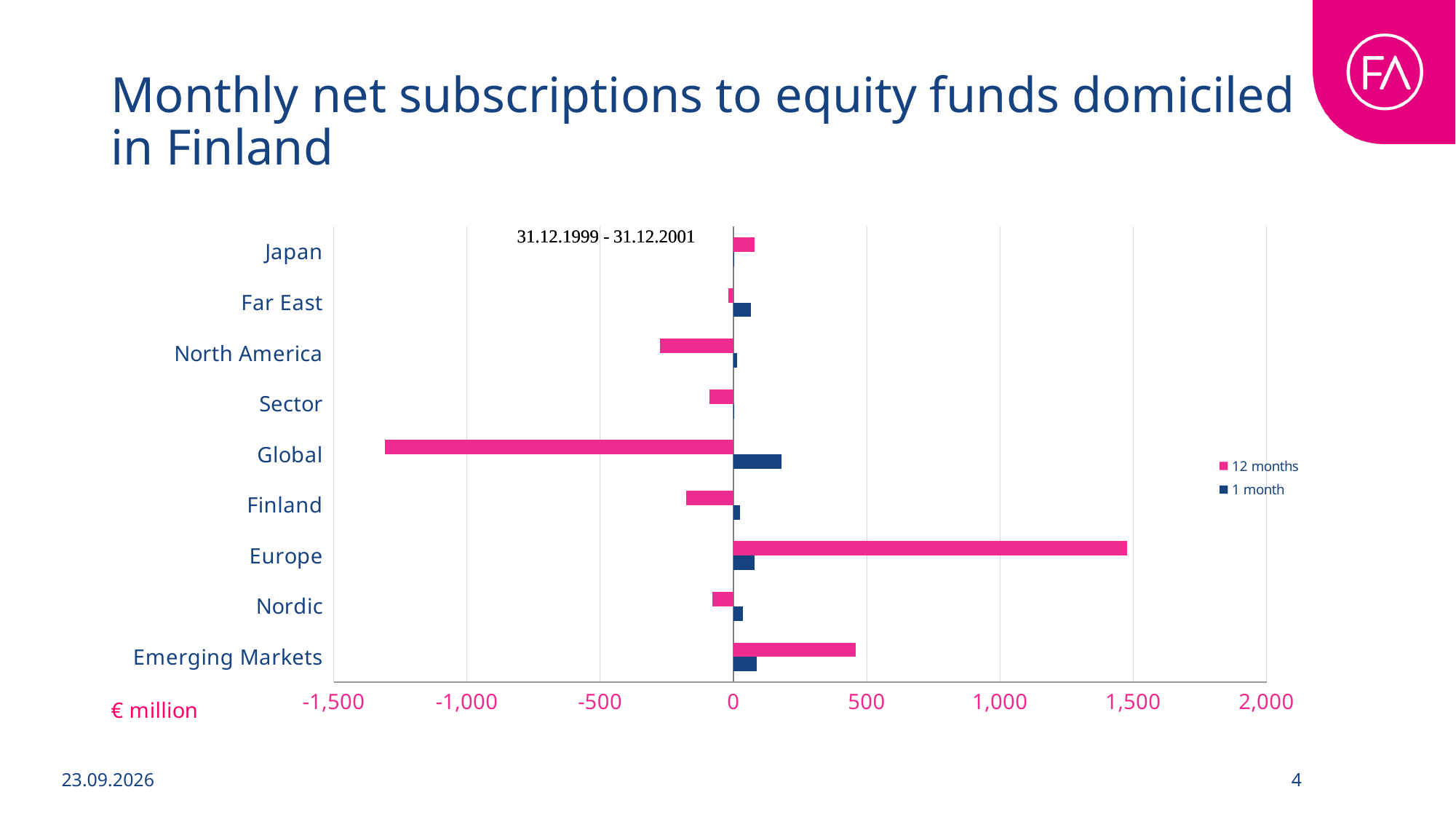
How many series does the legend list? 2 Is the 12 months value for North America greater or less than -500? greater Is the 12 months value for Global greater or less than -1,000? less What kind of chart is shown on the slide? bar chart Is the 12 months value for Emerging Markets greater or less than 500? less What unit is shown for the values on the chart? € million Which is larger, the 1 month value for Global or for Europe? Global How many categories are shown on the chart? 9 Which category has the highest 12 months value? Europe Which is larger, the 12 months value for Europe or for Emerging Markets? Europe Which category has the lowest 12 months value? Global